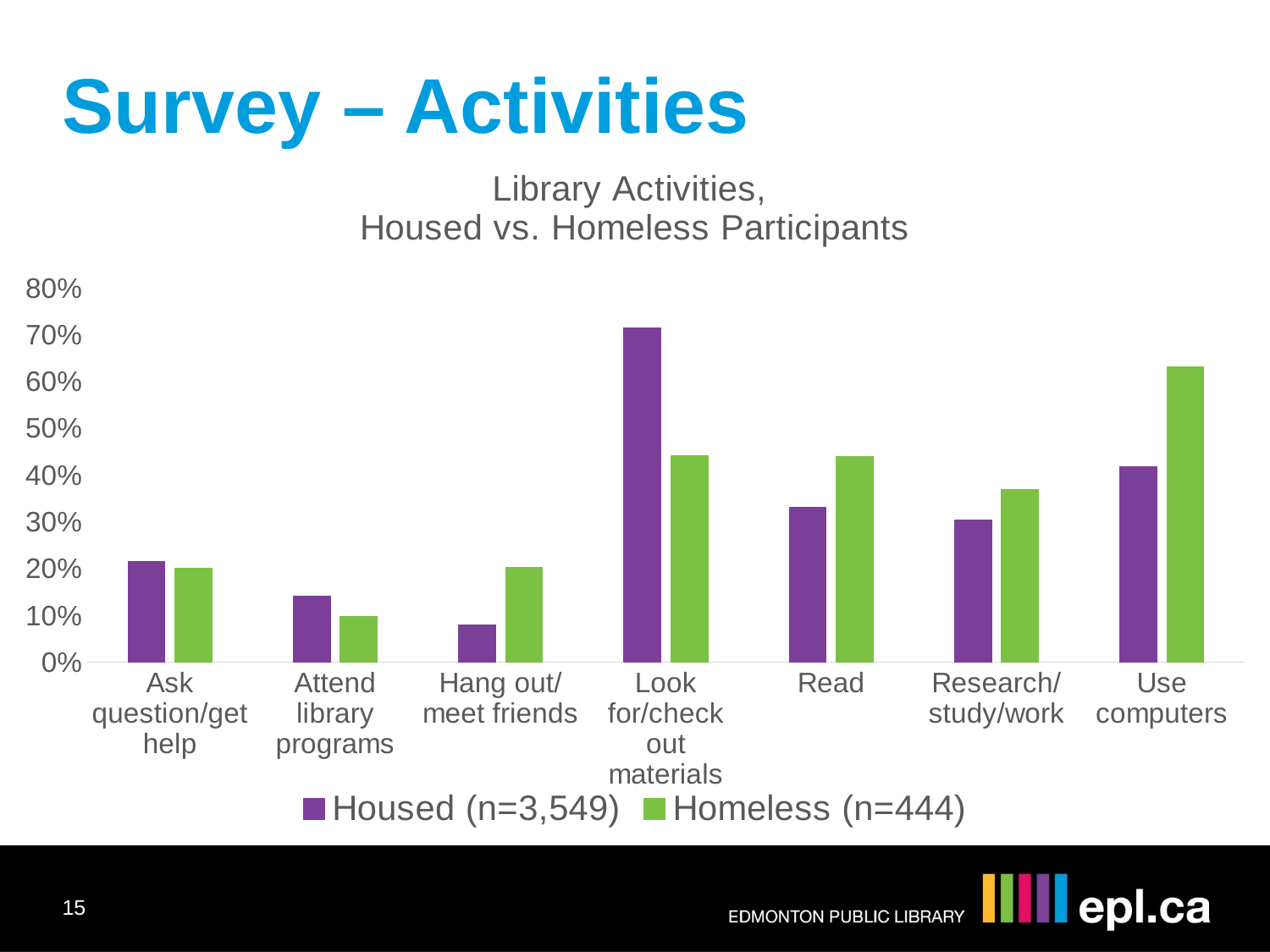
Is the Housed value for Hang out/meet friends greater or less than 10%? less For Hang out/meet friends, which series has the larger value, Housed or Homeless? Homeless For Use computers, which series has the larger value, Housed or Homeless? Homeless Which activity has the highest value for the Housed (n=3,549) series? Look for/check out materials Is the Housed value for Look for/check out materials greater or less than 60%? greater Which activity has the highest value for the Homeless (n=444) series? Use computers How many activity categories are shown on the x axis? 7 What kind of chart is shown on the slide? bar chart What is the title of the chart? Library Activities, Housed vs. Homeless Participants For Look for/check out materials, which series has the larger value, Housed or Homeless? Housed How many series does the legend list? 2 Which activity has the lowest value for the Housed (n=3,549) series? Hang out/meet friends